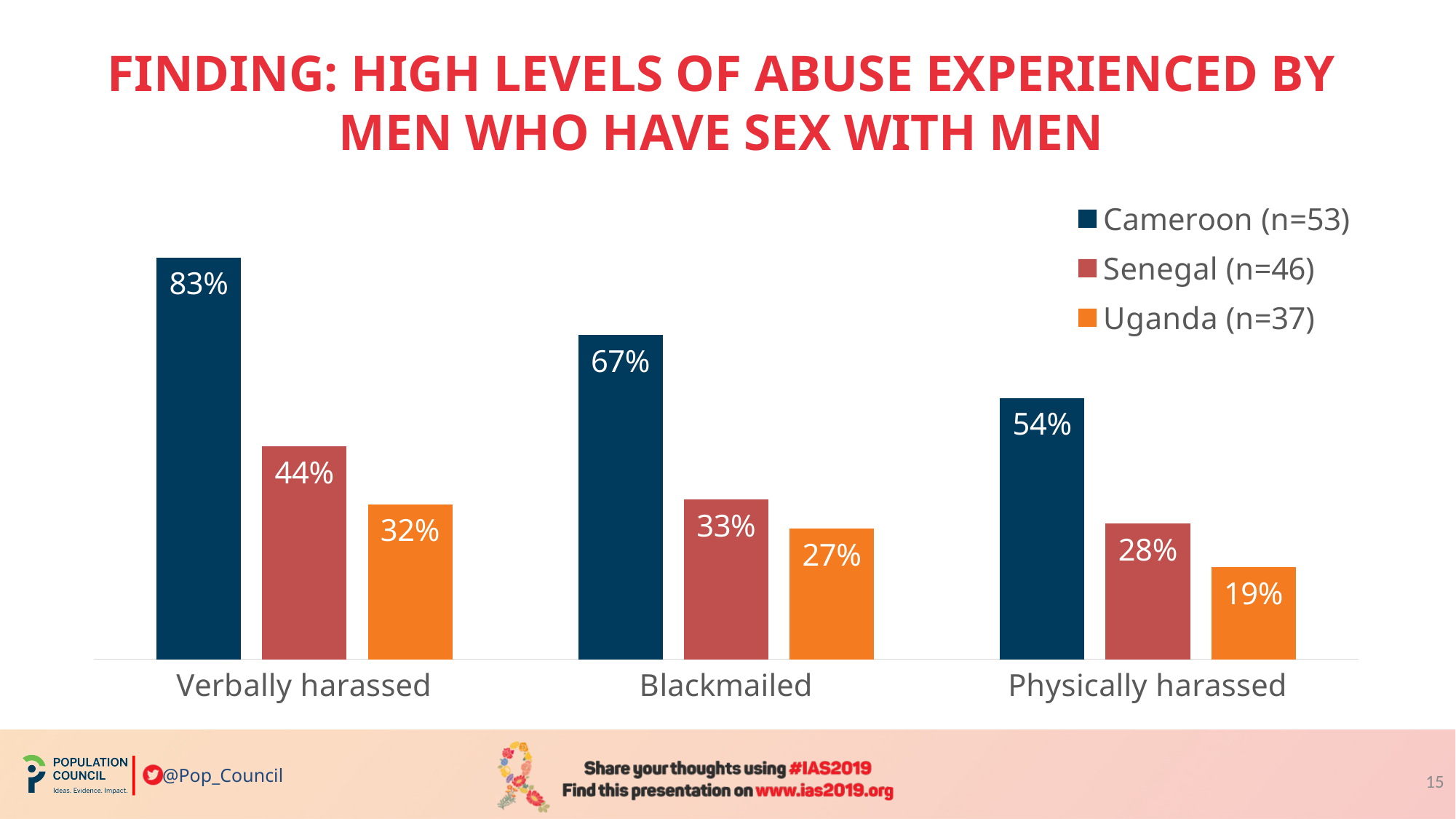
What is the value for Uganda in the Blackmailed category? 27% Which is larger: the Senegal value for Blackmailed or the Uganda value for Verbally harassed? Senegal value for Blackmailed (33%) What percentage of men in Cameroon reported being verbally harassed? 83% What kind of chart is shown on the slide? Bar chart How many series does the legend list? 3 Which country has the highest value for Blackmailed? Cameroon How many abuse categories are shown on the x axis? 3 Do the Cameroon values rise or fall from Verbally harassed to Physically harassed? Fall Which country has the lowest value for Physically harassed? Uganda What percentage of men in Senegal reported being physically harassed? 28% What sample size is given for Uganda in the legend? n=37 What is the difference between the Cameroon and Senegal values for Verbally harassed? 39 percentage points